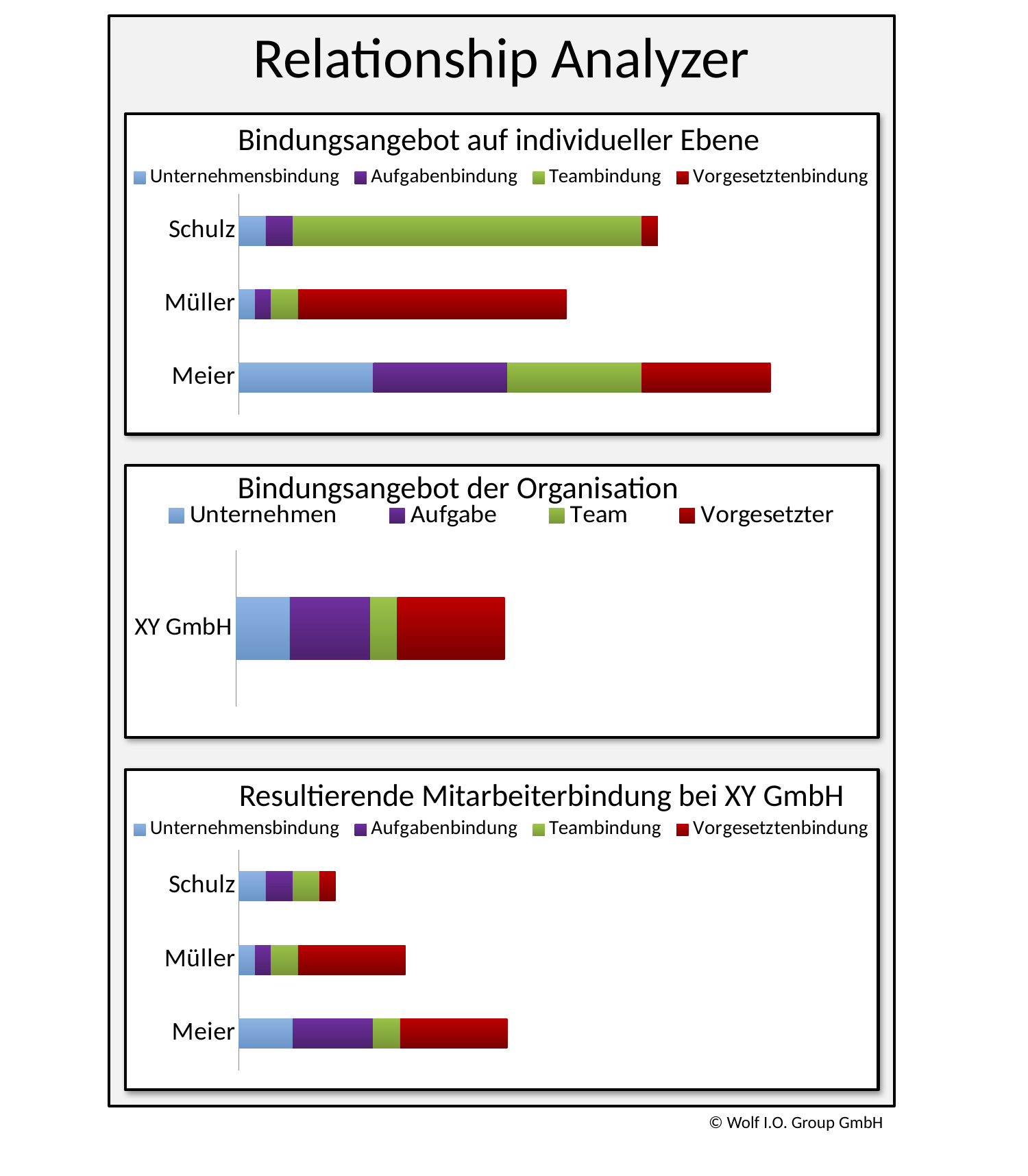
In the chart "Bindungsangebot der Organisation", which series has the smallest segment for XY GmbH? Team In the chart "Bindungsangebot auf individueller Ebene", which series makes up the largest part of Schulz's bar? Teambindung In the chart "Bindungsangebot auf individueller Ebene", how many series does the legend list? 4 In the chart "Resultierende Mitarbeiterbindung bei XY GmbH", which person has the shortest total bar? Schulz In the chart "Bindungsangebot auf individueller Ebene", which person has the longest total bar? Meier In the chart "Resultierende Mitarbeiterbindung bei XY GmbH", which person has the longest total bar? Meier In the chart "Bindungsangebot auf individueller Ebene", how many categories (people) are shown? 3 In the chart "Bindungsangebot auf individueller Ebene", which person has the shortest total bar? Müller In the chart "Resultierende Mitarbeiterbindung bei XY GmbH", whose total bar is longer, Müller or Schulz? Müller What kind of chart is "Bindungsangebot auf individueller Ebene"? Stacked bar chart In the chart "Bindungsangebot der Organisation", how many categories are plotted? 1 In the chart "Bindungsangebot der Organisation", which series has the largest segment for XY GmbH? Vorgesetzter